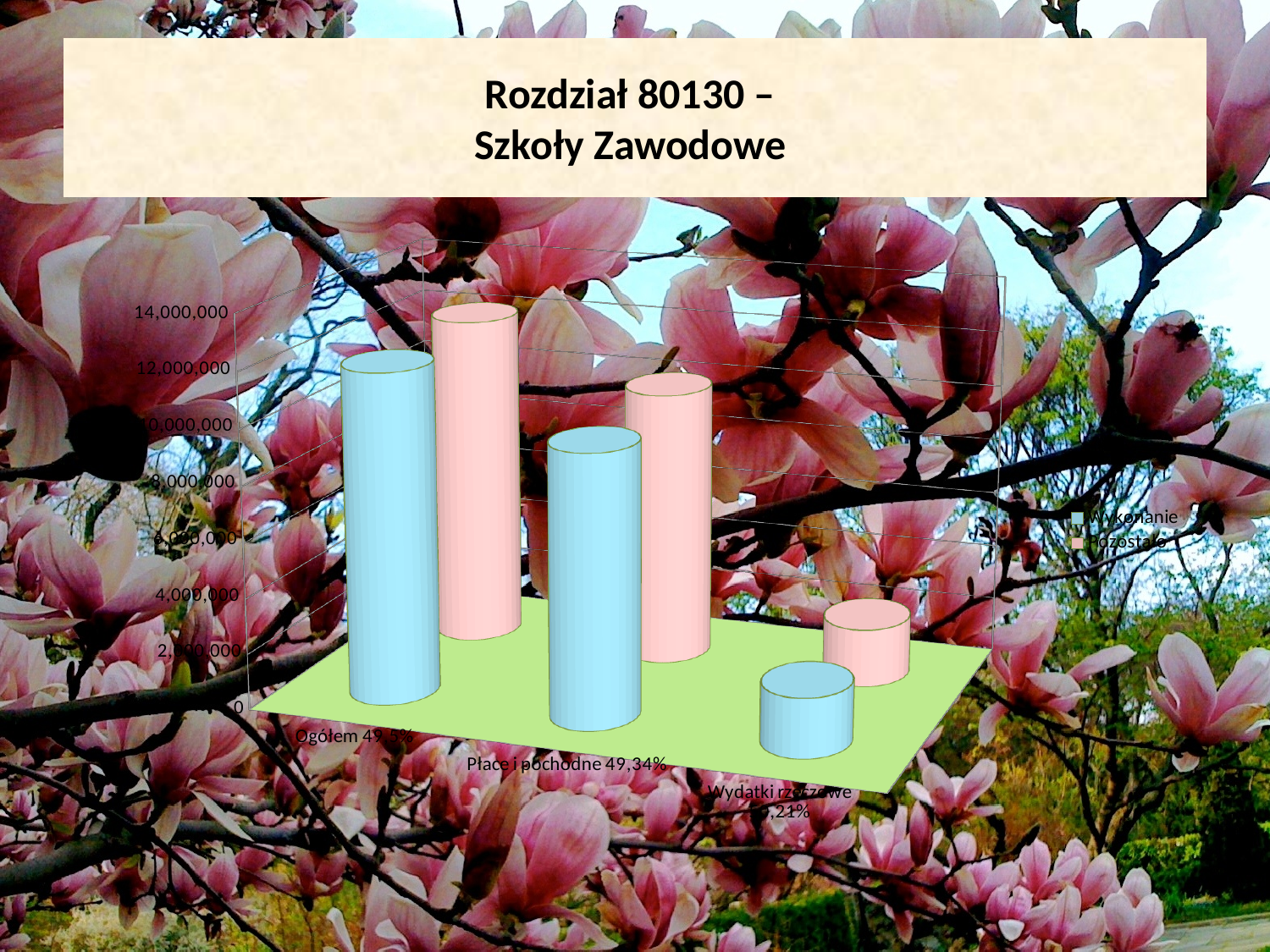
Which category has the lowest Pozostało value? Wydatki rzeczowe Which category has the lowest Wykonanie value? Wydatki rzeczowe Is the Wykonanie value for Ogółem 49,5% greater or less than 10,000,000? greater Which category has the highest Wykonanie value? Ogółem 49,5% What is the title of the slide containing the chart? Rozdział 80130 – Szkoły Zawodowe How many categories are shown on the chart's x axis? 3 Which is larger: the Wykonanie value for Ogółem 49,5% or the Wykonanie value for Wydatki rzeczowe? Ogółem 49,5% Is the Wykonanie value for Płace i pochodne 49,34% greater or less than 8,000,000? greater What kind of chart is shown on the slide? bar chart How many series does the chart legend list? 2 What are the two series named in the chart legend? Wykonanie and Pozostało Is the Wykonanie value for Wydatki rzeczowe greater or less than 4,000,000? less